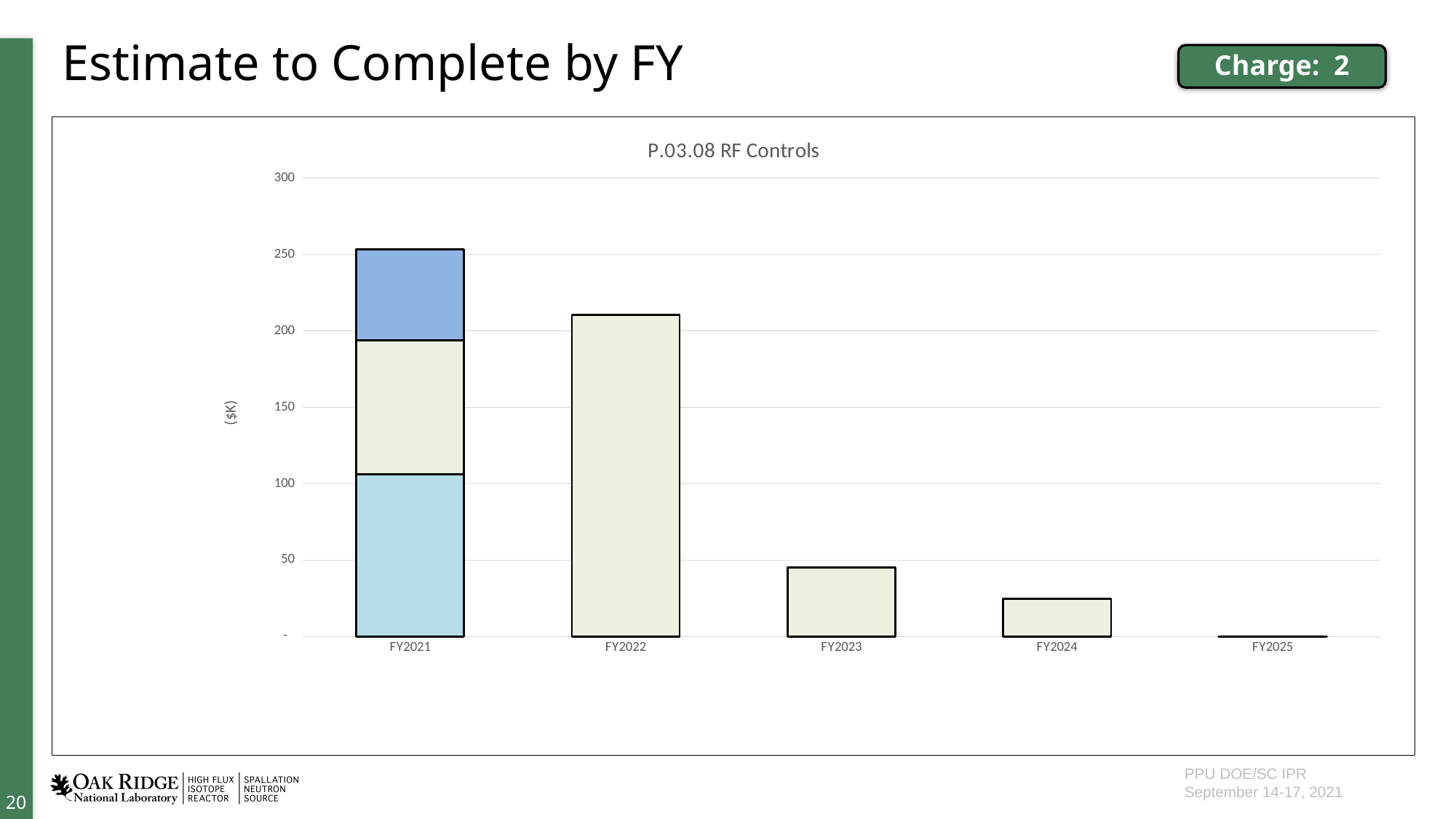
How many fiscal years are shown on the x axis of the chart? 5 Which fiscal year has the tallest bar in the chart? FY2021 Is the total for FY2021 greater or less than 200? greater Which fiscal year has the smallest bar in the chart? FY2025 Is the value for FY2023 greater or less than 50? less What is the label on the vertical axis of the chart? ($K) What kind of chart is shown on the slide? bar chart Do the bar heights rise or fall from FY2021 to FY2025? fall Is the value for FY2022 greater or less than 200? greater Which bar is taller, FY2023 or FY2024? FY2023 What is the title of the chart? P.03.08 RF Controls